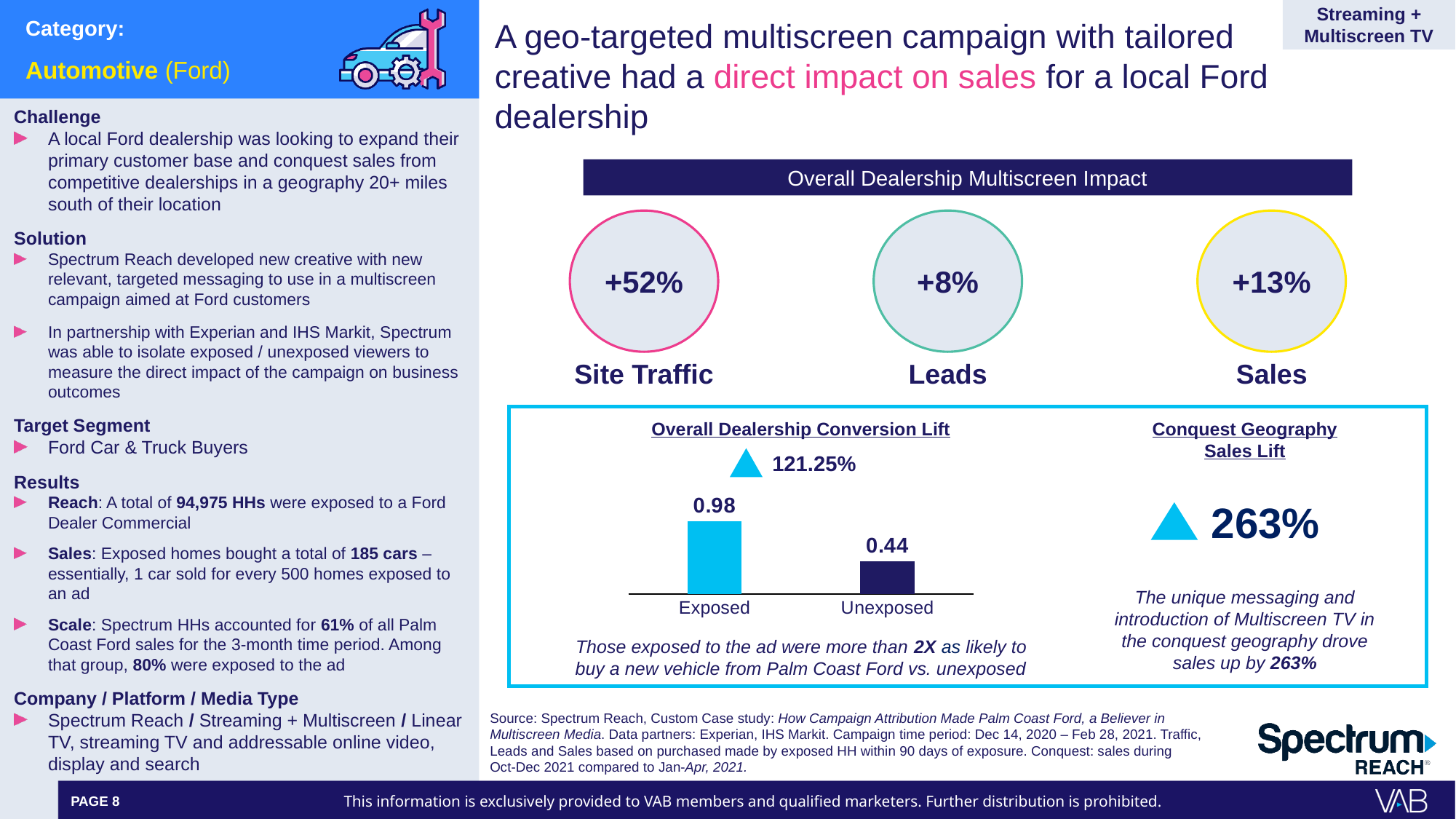
In the Overall Dealership Conversion Lift chart, is the value for Exposed or Unexposed larger? Exposed In the Overall Dealership Conversion Lift chart, what is the difference between the Exposed and Unexposed values? 0.54 What lift percentage is shown above the Overall Dealership Conversion Lift chart? 121.25% What is the title of the bar chart on the slide? Overall Dealership Conversion Lift In the Overall Dealership Conversion Lift chart, what is the value for Exposed? 0.98 How many categories are shown in the Overall Dealership Conversion Lift chart? 2 In the Overall Dealership Conversion Lift chart, do the values rise or fall from Exposed to Unexposed? Fall In the Overall Dealership Conversion Lift chart, which category has the highest value? Exposed What kind of chart is the Overall Dealership Conversion Lift chart? Bar chart In the Overall Dealership Conversion Lift chart, what is the value for Unexposed? 0.44 In the Overall Dealership Conversion Lift chart, which category has the lowest value? Unexposed